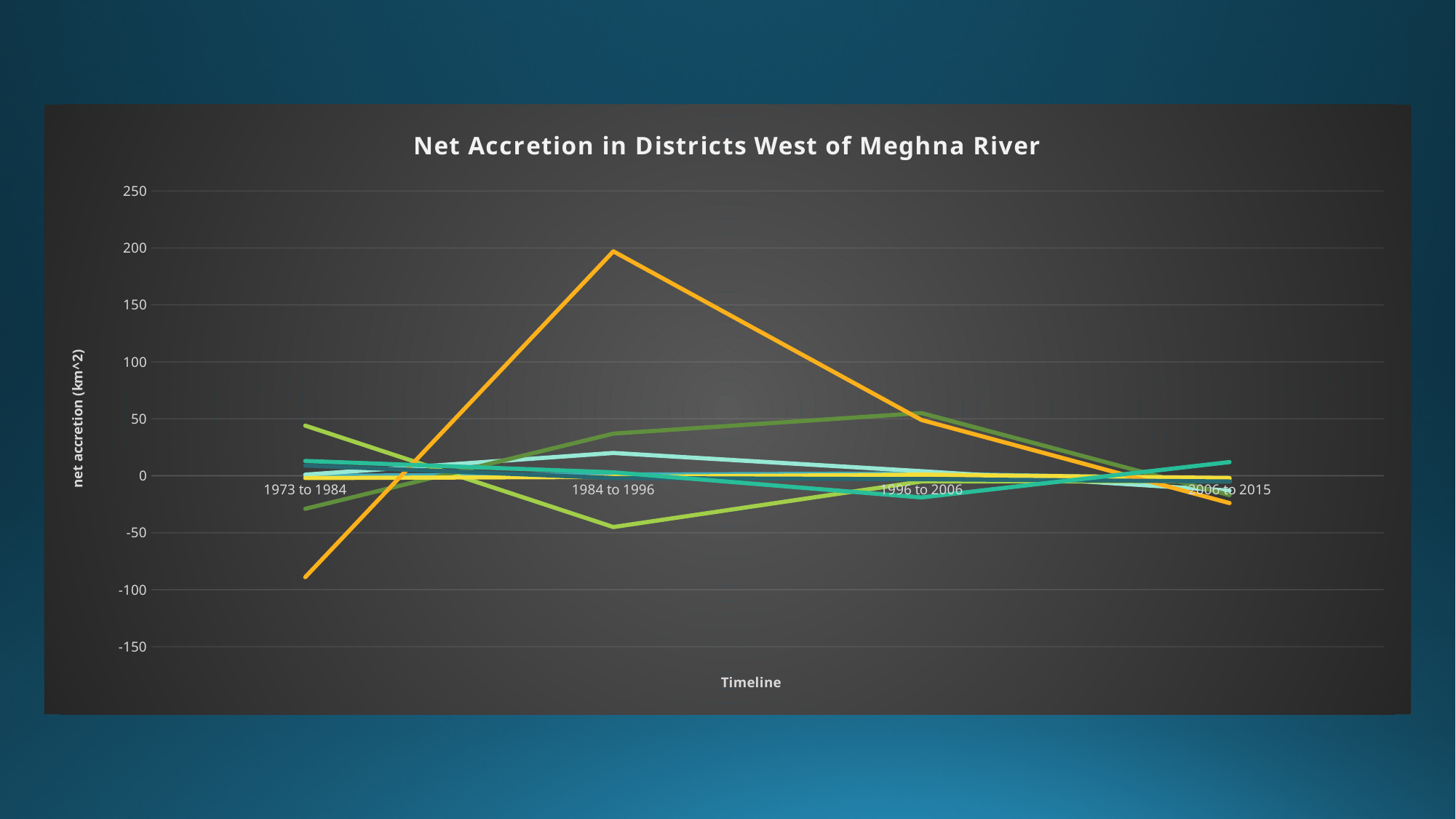
In which period does the orange line reach its highest value? 1984 to 1996 What kind of chart is shown on the slide? line chart What is the label of the vertical axis? net accretion (km^2) Is the value of the orange line for 1973 to 1984 greater or less than -50? less In which period does the orange line reach its lowest value? 1973 to 1984 Is the value of the orange line for 1984 to 1996 greater or less than 150? greater What is the title of the chart? Net Accretion in Districts West of Meghna River Does the orange line rise or fall from 1984 to 1996 through 2006 to 2015? fall Is the value of the orange line for 1996 to 2006 greater or less than 0? greater How many time periods are shown along the x axis? 4 Which is larger for the orange line: the value for 1984 to 1996 or the value for 1996 to 2006? 1984 to 1996